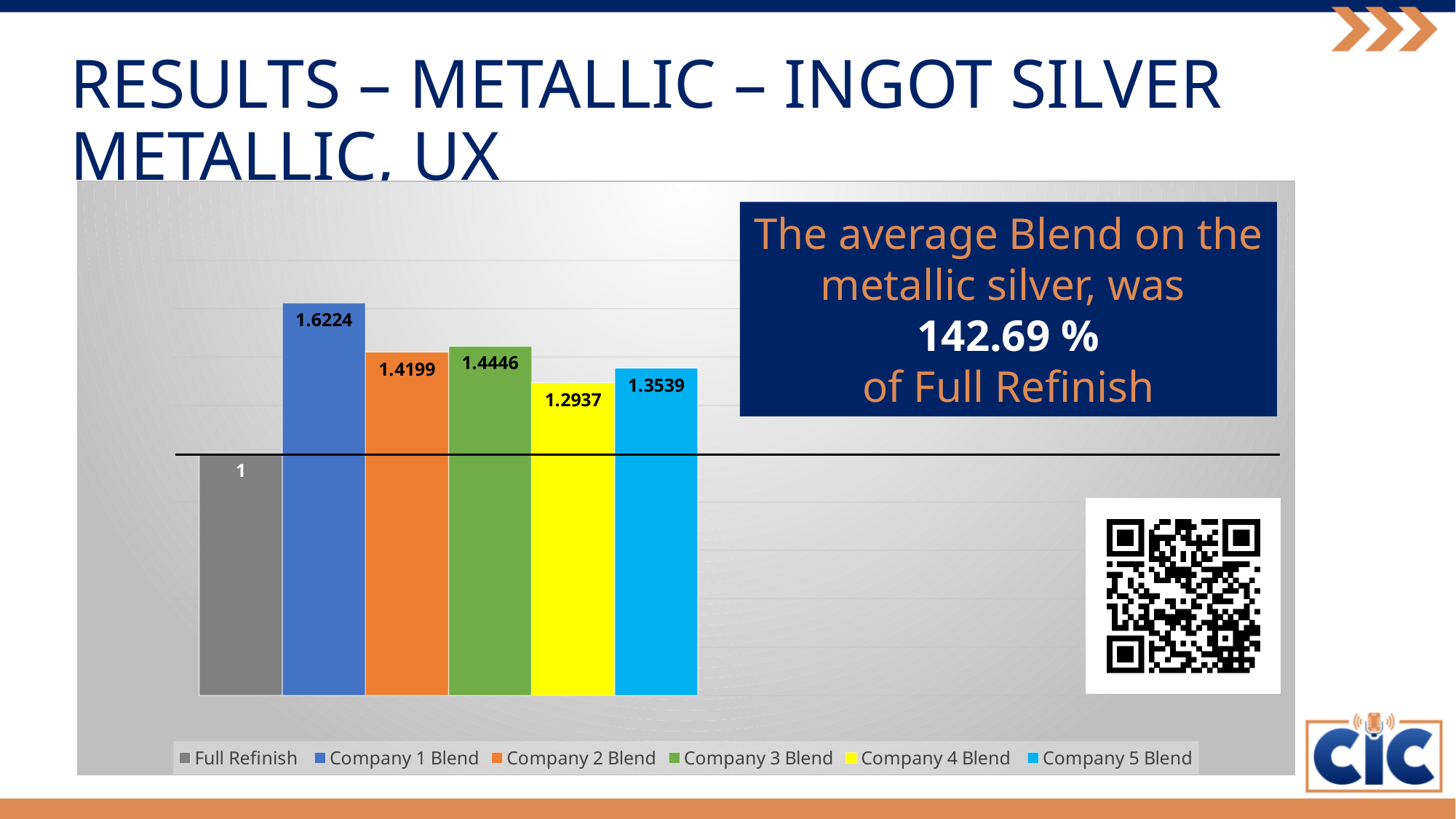
Which is larger, the value for Company 3 Blend or Company 2 Blend? Company 3 Blend Which series has the lowest value in the chart? Full Refinish What is the difference between the values for Company 1 Blend and Company 2 Blend? 0.2025 What kind of chart is shown on the slide? Bar chart Which series has the highest value in the chart? Company 1 Blend What is the value shown for Company 1 Blend? 1.6224 What is the value shown for Full Refinish? 1 How many bars are plotted in the chart? 6 How many series does the legend list? 6 What is the value shown for Company 5 Blend? 1.3539 What is the value shown for Company 4 Blend? 1.2937 What colour is the bar for Company 4 Blend? Yellow